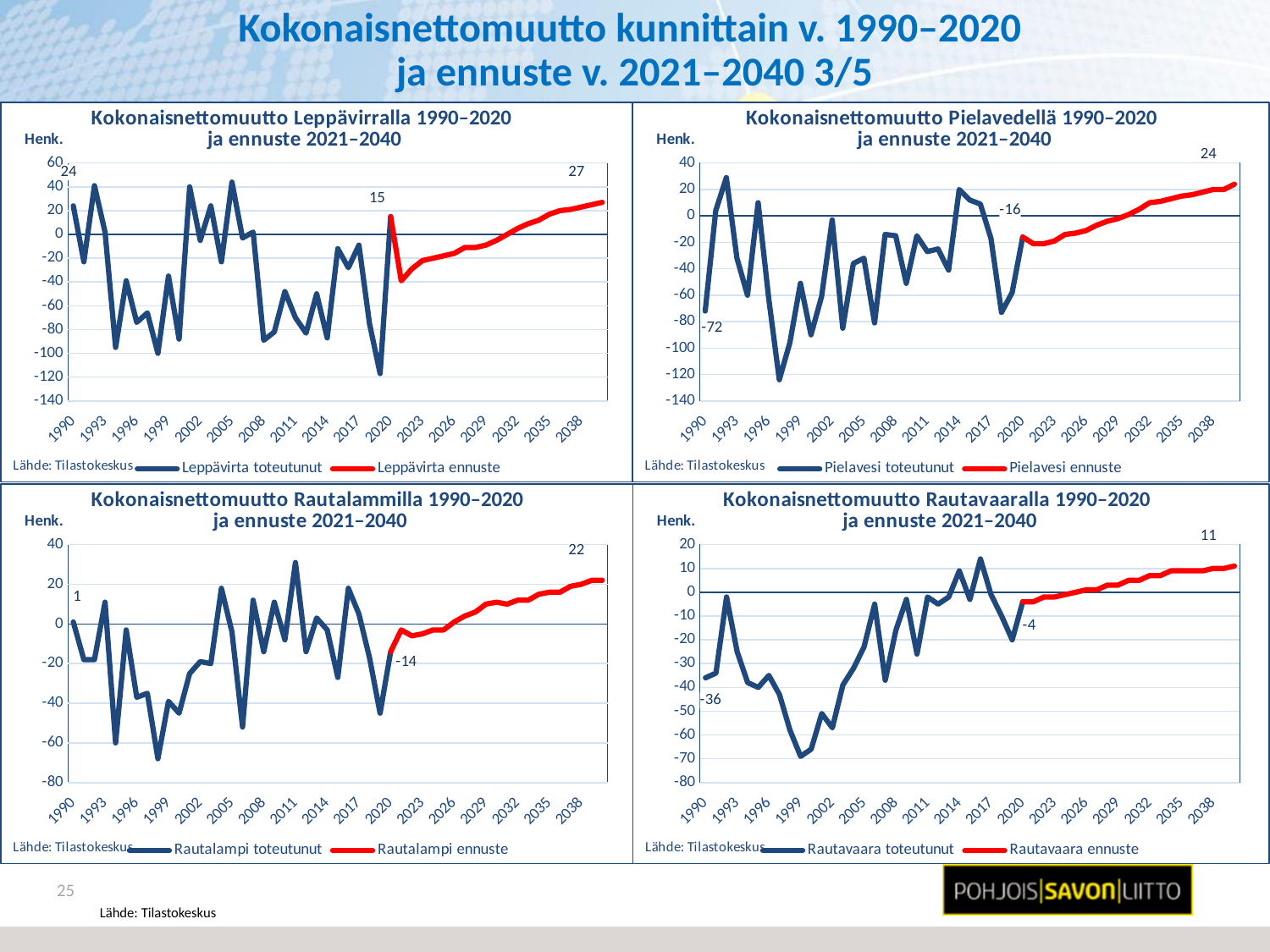
What kind of chart is the Rautavaara chart (bottom right)? line chart In the Leppävirta chart (top left), what value is labelled for 1990? 24 In the Leppävirta chart (top left), what is the labelled forecast value for 2040? 27 In the Leppävirta chart (top left), is the value for 2019 greater or less than -100? less In the Rautalampi chart (bottom left), what value is labelled for 2020? -14 In the Pielavesi chart (top right), is the lowest value of the realised series greater or less than -100? less How many series does the legend of the Rautalampi chart (bottom left) list? 2 In the Rautavaara chart (bottom right), what is the labelled forecast value for 2040? 11 In the Pielavesi chart (top right), what value is labelled for 2020? -16 In the Rautalampi chart (bottom left), which is larger: the labelled value for 1990 or the labelled value for 2040? 2040 In the Leppävirta chart (top left), what is the difference between the 2040 forecast value (27) and the 2020 value (15)? 12 In the Pielavesi chart (top right), what value is labelled for 1990? -72